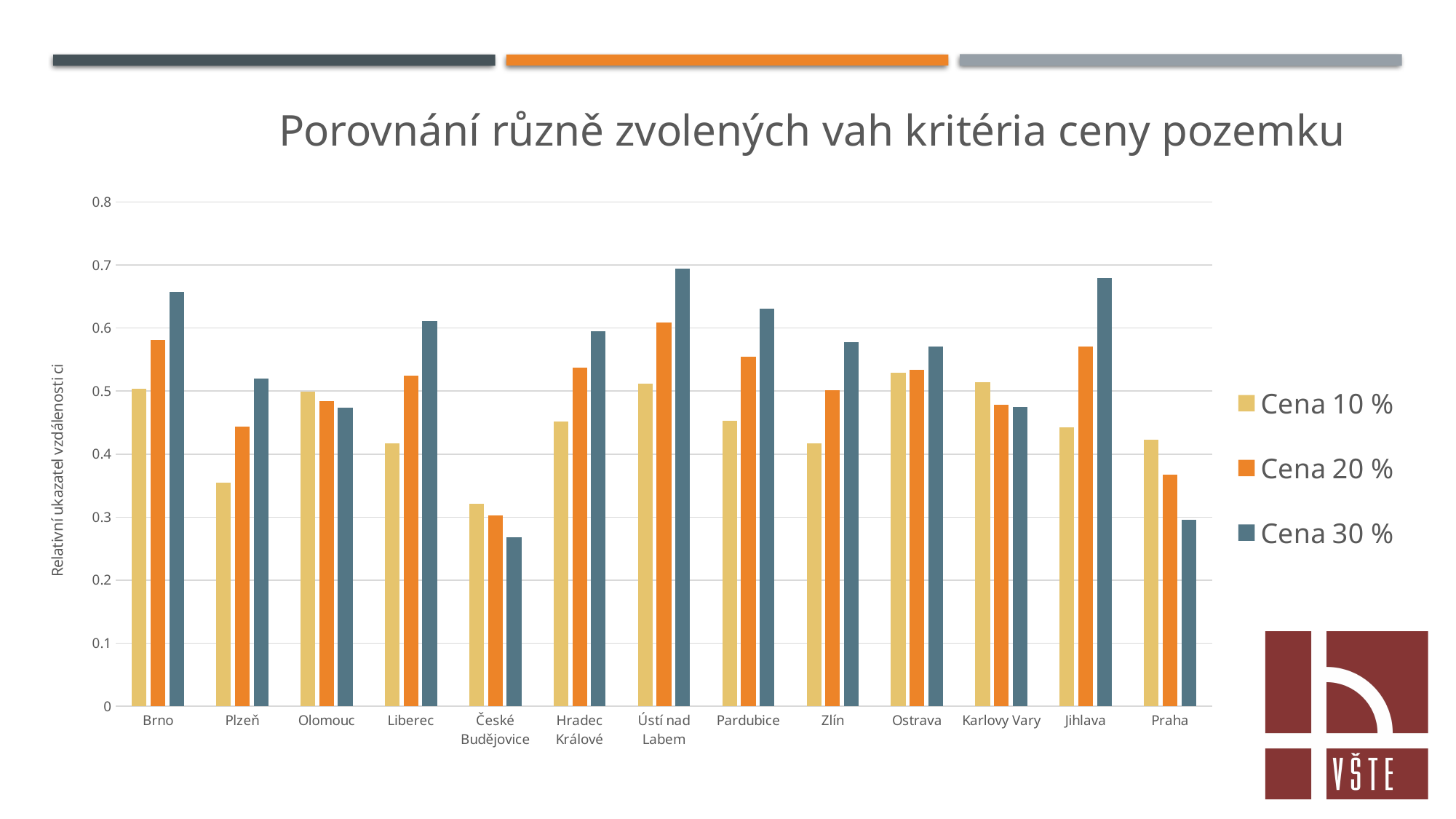
Is the value for Plzeň in the Cena 10 % series greater or less than 0.4? less For Praha, which is larger: the Cena 10 % value or the Cena 30 % value? Cena 10 % What kind of chart is shown on the slide? bar chart What is the label of the vertical axis? Relativní ukazatel vzdálenosti ci How many cities are shown on the x axis? 13 What is the title of the chart? Porovnání různě zvolených vah kritéria ceny pozemku Which city has the highest value for Cena 20 %? Ústí nad Labem Is the value for Brno in the Cena 30 % series greater or less than 0.6? greater Which city has the lowest value for Cena 20 %? České Budějovice How many series does the legend list? 3 For Liberec, which is larger: the Cena 10 % value or the Cena 30 % value? Cena 30 % Which city has the lowest value for Cena 30 %? České Budějovice